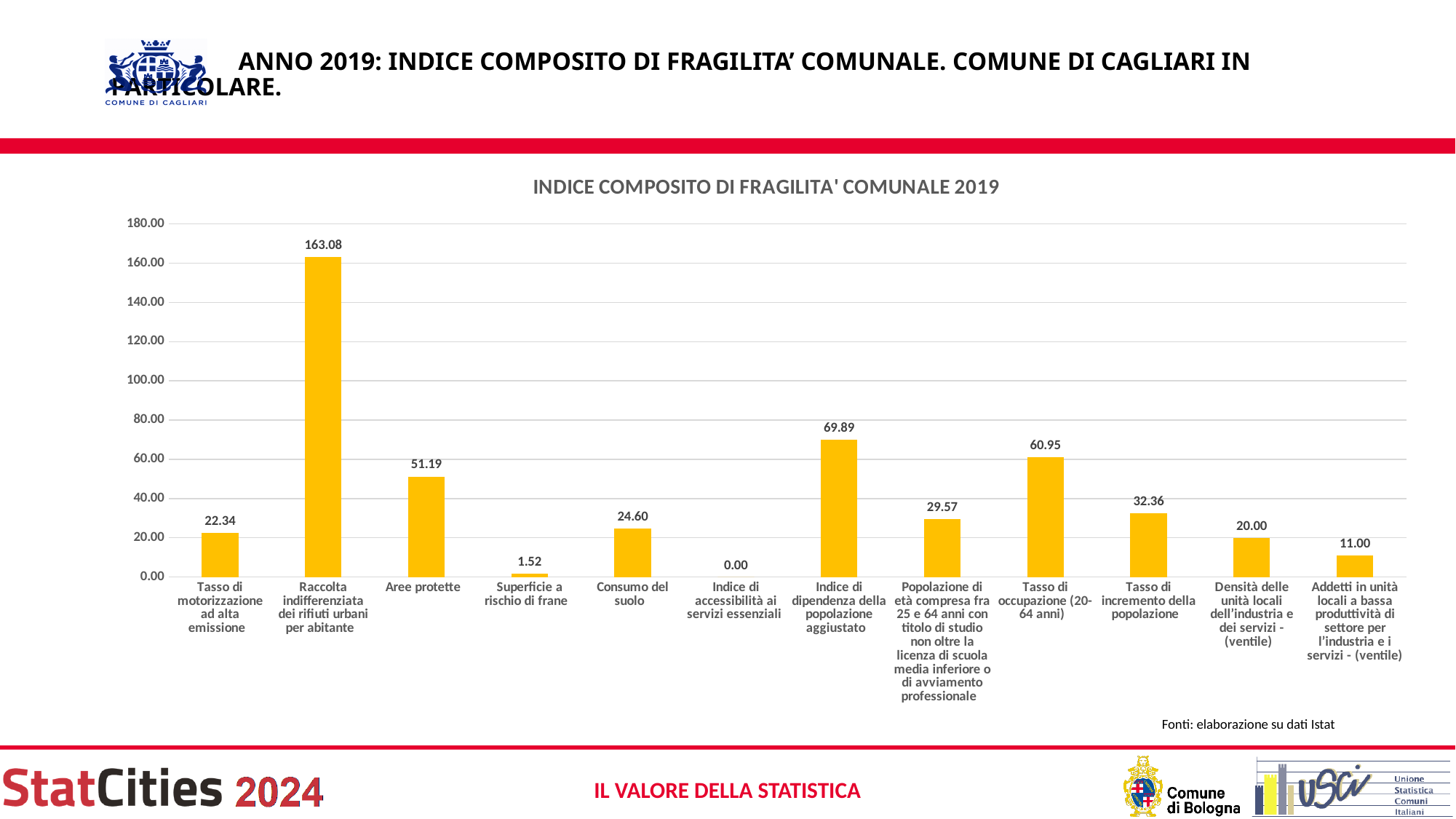
Is the value for Raccolta indifferenziata dei rifiuti urbani per abitante greater or less than 140.00? greater What kind of chart is shown on the slide? bar chart What is the value for Consumo del suolo? 24.60 Which category has the highest value? Raccolta indifferenziata dei rifiuti urbani per abitante What is the title of the chart? INDICE COMPOSITO DI FRAGILITA' COMUNALE 2019 What is the value for Aree protette? 51.19 Which is larger: the value for Tasso di incremento della popolazione or the value for Densità delle unità locali dell'industria e dei servizi - (ventile)? Tasso di incremento della popolazione What is the difference between the values for Indice di dipendenza della popolazione aggiustato and Tasso di occupazione (20-64 anni)? 8.94 What colour are the bars in the chart? yellow How many categories are shown on the x axis? 12 Which category has the lowest value? Indice di accessibilità ai servizi essenziali What is the value for Tasso di occupazione (20-64 anni)? 60.95